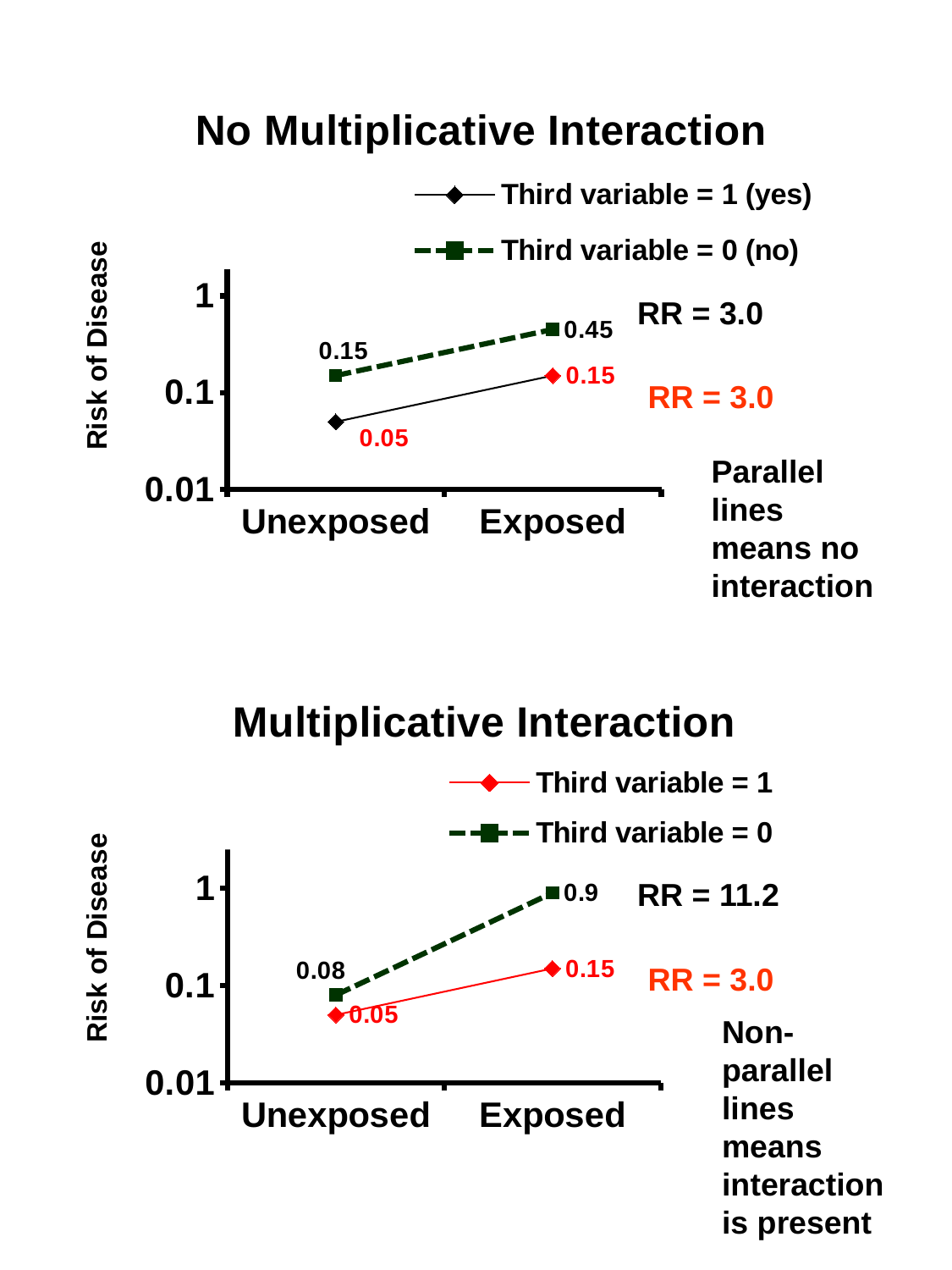
What kind of chart is the 'No Multiplicative Interaction' chart? Line chart In the 'No Multiplicative Interaction' chart, what is the risk of disease for the Exposed group when the third variable = 0 (no)? 0.45 In the 'Multiplicative Interaction' chart, does the risk for the third variable = 0 series rise or fall from Unexposed to Exposed? Rise How many series does the legend of the 'Multiplicative Interaction' chart list? 2 In the 'No Multiplicative Interaction' chart, what is the difference in risk between Exposed and Unexposed for the third variable = 0 (no) series? 0.3 In the 'No Multiplicative Interaction' chart, what is the risk of disease for the Unexposed group when the third variable = 1 (yes)? 0.05 In the 'Multiplicative Interaction' chart, which series has the higher risk for the Exposed group? Third variable = 0 In the 'Multiplicative Interaction' chart, what is the difference in risk between Exposed and Unexposed for the third variable = 1 series? 0.1 In the 'Multiplicative Interaction' chart, what is the risk of disease for the Unexposed group when the third variable = 0? 0.08 In the 'Multiplicative Interaction' chart, is the risk for the Exposed group with third variable = 0 greater or less than 0.1? greater In the 'Multiplicative Interaction' chart, what is the risk of disease for the Exposed group when the third variable = 0? 0.9 In the 'No Multiplicative Interaction' chart, which point has the highest risk of disease? Exposed, Third variable = 0 (no)